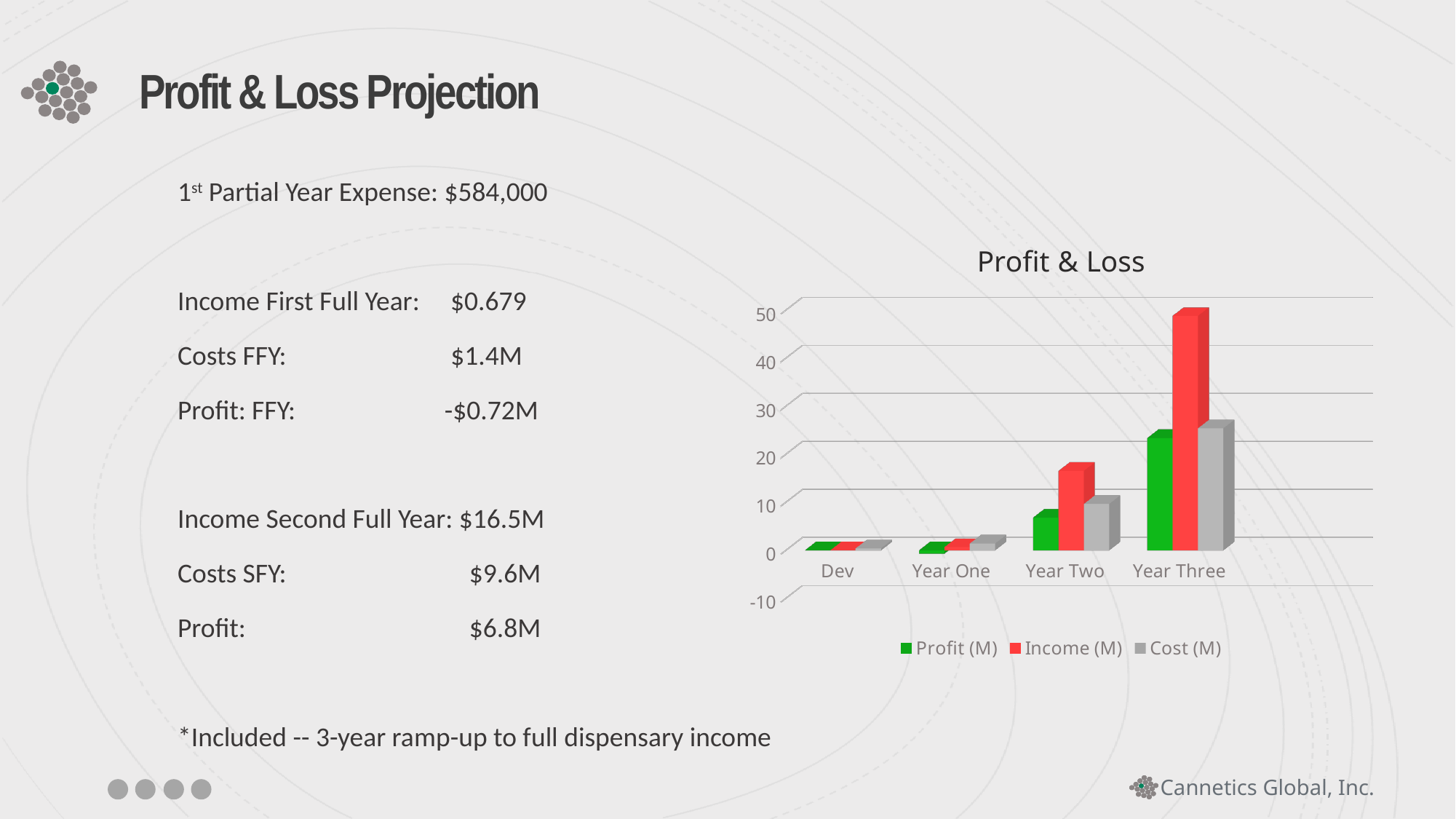
Is the Profit (M) value for Year Two greater or less than 10? less How many series does the legend of the Profit & Loss chart list? 3 Is the Cost (M) value for Year Three greater or less than 30? less Which colour represents the Income (M) series in the chart? red Is the Income (M) value for Year Two greater or less than 10? greater How many categories are shown on the x axis of the Profit & Loss chart? 4 Which category has the highest Income (M) value? Year Three Do the Income (M) values rise or fall from Dev to Year Three? rise What is the title of the chart? Profit & Loss What kind of chart is shown on the slide? bar chart Which is larger, the Income (M) value for Year Two or the Cost (M) value for Year Two? Income (M)